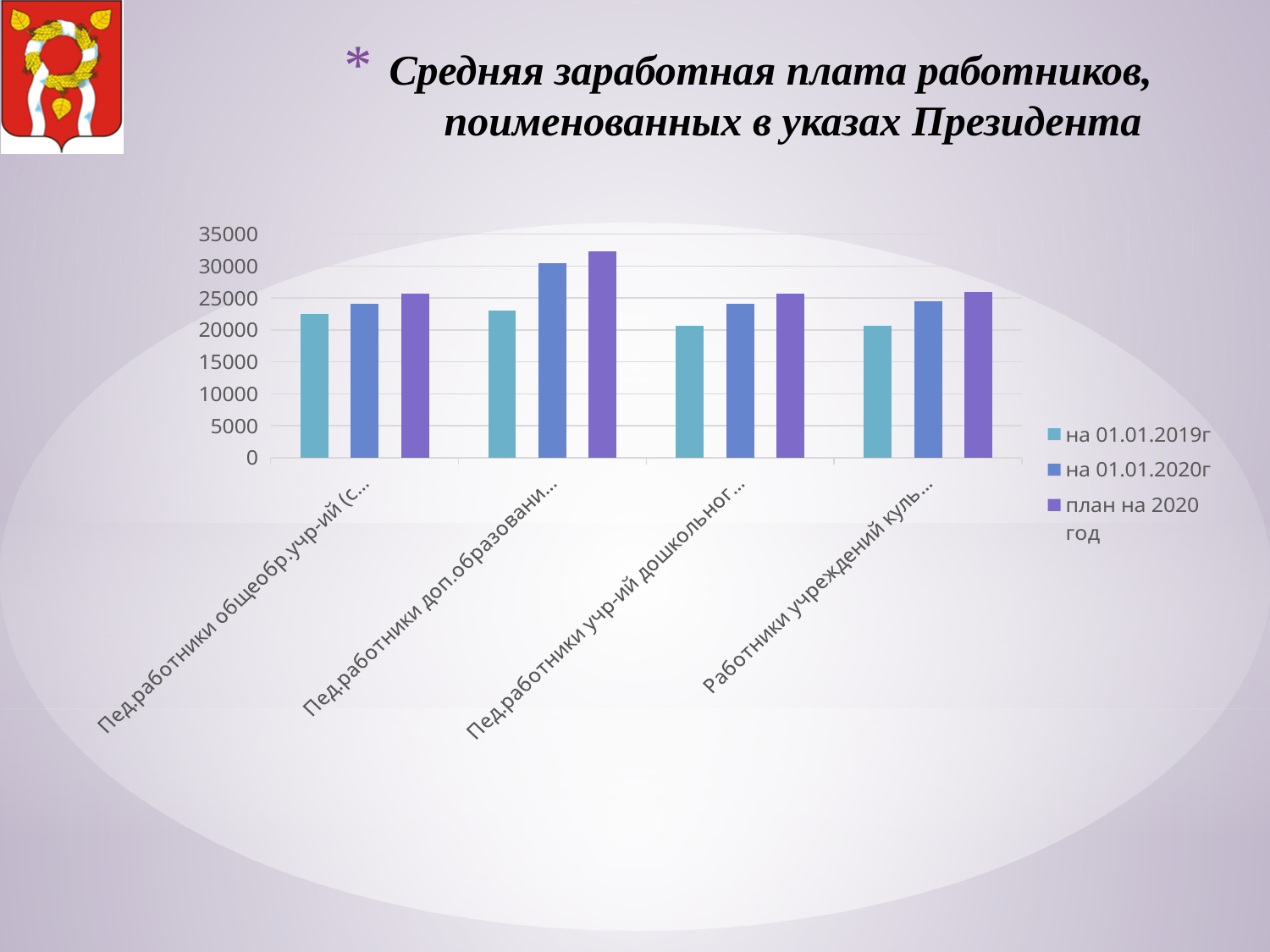
How many series does the legend list? 3 Is the value for "на 01.01.2019г" for the category "Пед.работники учр-ий дошкольног..." greater or less than 25000? less Is the value for "план на 2020 год" for the category "Пед.работники доп.образовани..." greater or less than 30000? greater What is the name of the third series in the legend? план на 2020 год Which category has the highest bar for the series "план на 2020 год"? Пед.работники доп.образовани... Which category has the highest bar for the series "на 01.01.2020г"? Пед.работники доп.образовани... For the series "план на 2020 год", which is larger: the value for "Пед.работники доп.образовани..." or the value for "Пед.работники общеобр.учр-ий (с..."? Пед.работники доп.образовани... Is the value for "на 01.01.2020г" for the category "Работники учреждений куль..." greater or less than 20000? greater Within the category "Пед.работники доп.образовани...", do the bars rise or fall from "на 01.01.2019г" to "план на 2020 год"? rise How many categories are shown on the x axis? 4 What type of chart is shown on the slide? bar chart